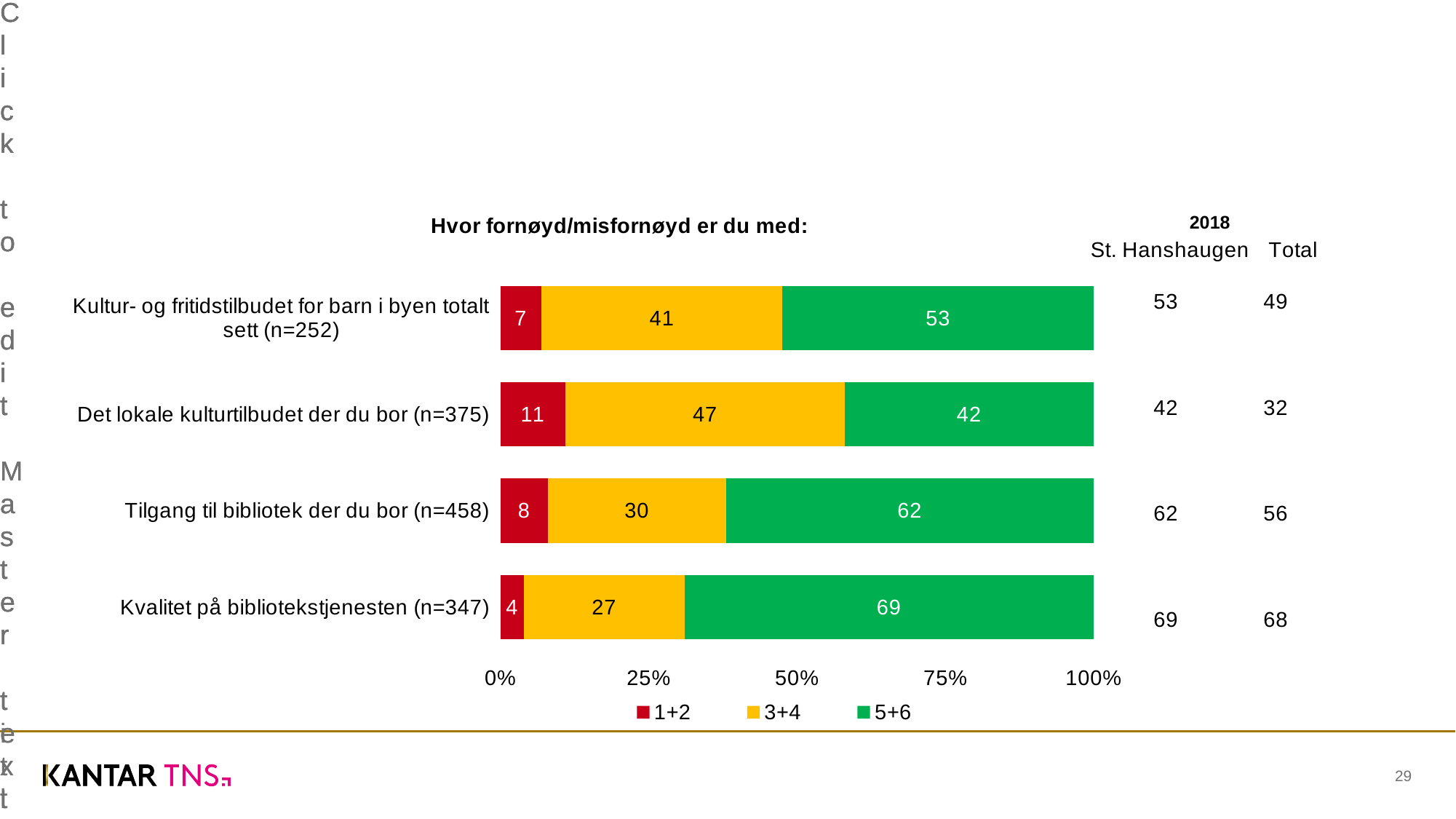
What is the title of the chart? Hvor fornøyd/misfornøyd er du med: What is the total of the stacked bar for "Det lokale kulturtilbudet der du bor (n=375)"? 100 How many series does the legend list? 3 What is the difference between the 3+4 values for "Det lokale kulturtilbudet der du bor (n=375)" and "Kvalitet på bibliotekstjenesten (n=347)"? 20 What is the value of the 3+4 series for "Tilgang til bibliotek der du bor (n=458)"? 30 Which is larger: the 5+6 value for "Tilgang til bibliotek der du bor (n=458)" or for "Kultur- og fritidstilbudet for barn i byen totalt sett (n=252)"? Tilgang til bibliotek der du bor (n=458) How many categories are shown in the chart? 4 What is the value of the 5+6 series for "Kvalitet på bibliotekstjenesten (n=347)"? 69 What kind of chart is shown on the slide? Stacked bar chart Which category has the lowest value for the 1+2 series? Kvalitet på bibliotekstjenesten (n=347) What is the value of the 1+2 series for "Det lokale kulturtilbudet der du bor (n=375)"? 11 Which category has the highest value for the 5+6 series? Kvalitet på bibliotekstjenesten (n=347)